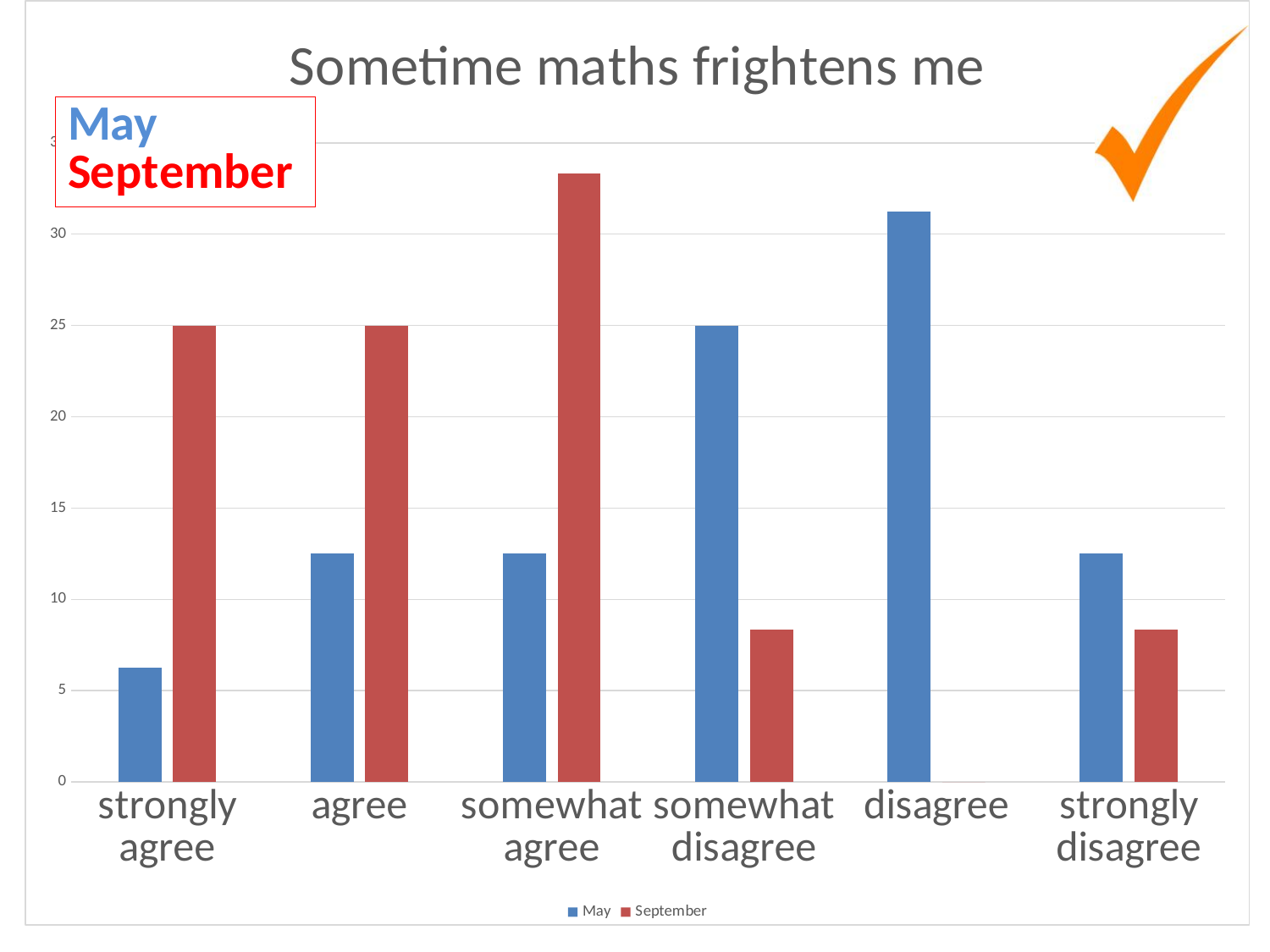
Which category has the lowest May value? strongly agree How many series does the legend list? 2 What is the September value for strongly agree? 25 Is the September value for somewhat disagree greater or less than 10? less Is the May value for disagree greater or less than 30? greater What kind of chart is shown on the slide? bar chart For strongly agree, which series has the larger value, May or September? September Which category has the highest May value? disagree How many categories are shown on the x axis? 6 Which category has the highest September value? somewhat agree What is the title of the chart? Sometime maths frightens me What is the May value for somewhat disagree? 25